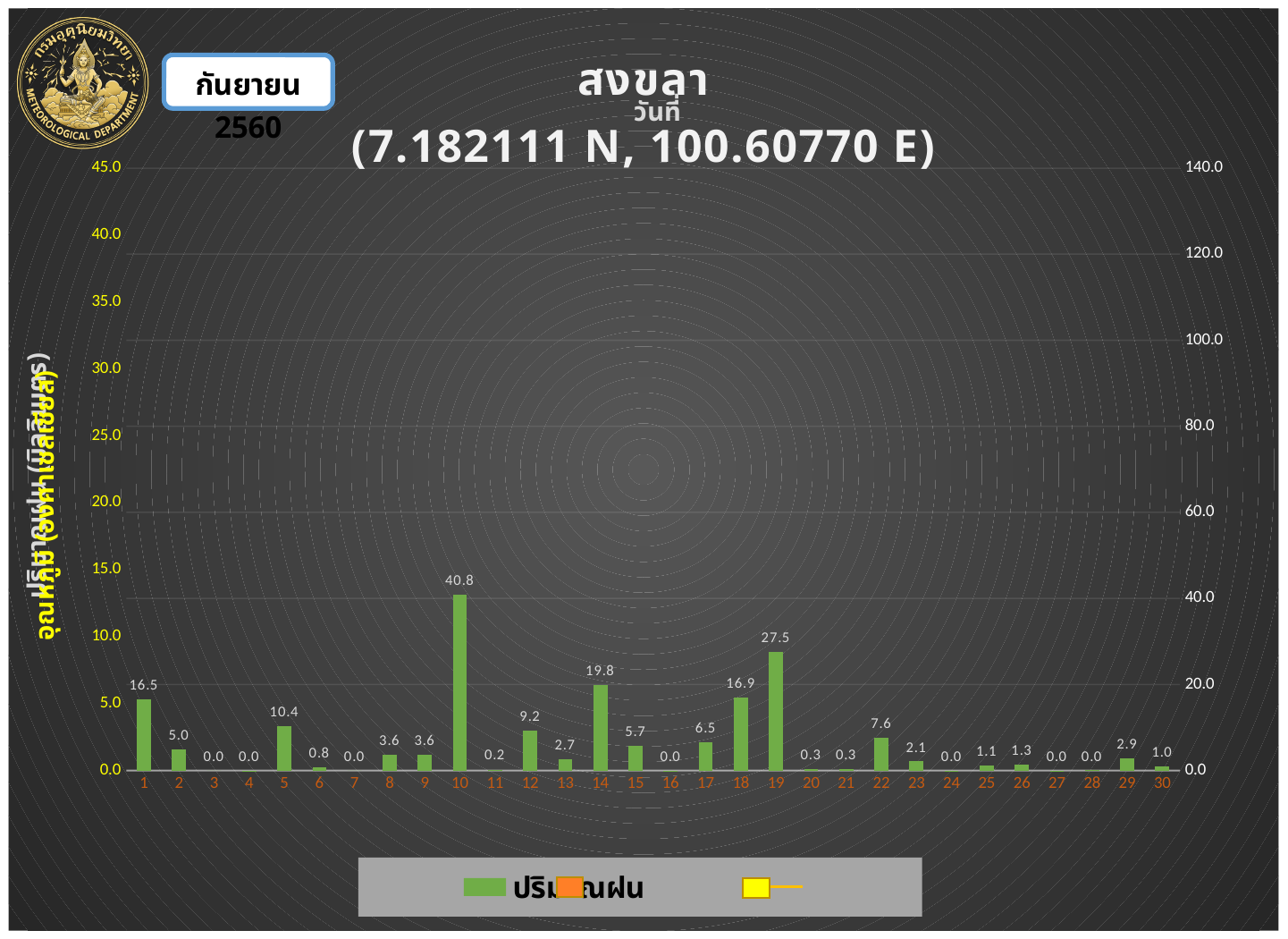
What kind of chart is used to show the rainfall data? bar chart Which day has the larger rainfall value, day 14 or day 22? 14 What is the rainfall value (ปริมาณฝน) shown for day 10? 40.8 Which day has the highest rainfall value? 10 Is the rainfall value for day 19 greater or less than 20.0 on the right axis? greater What is the rainfall value shown for day 2? 5.0 What is the difference between the rainfall values for day 10 and day 19? 13.3 What is the rainfall value shown for day 19? 27.5 What is the difference between the rainfall values for day 14 and day 18? 2.9 How many days are shown on the x axis of the chart? 30 What colour are the bars for ปริมาณฝน in the legend? green What is the rainfall value shown for day 14? 19.8